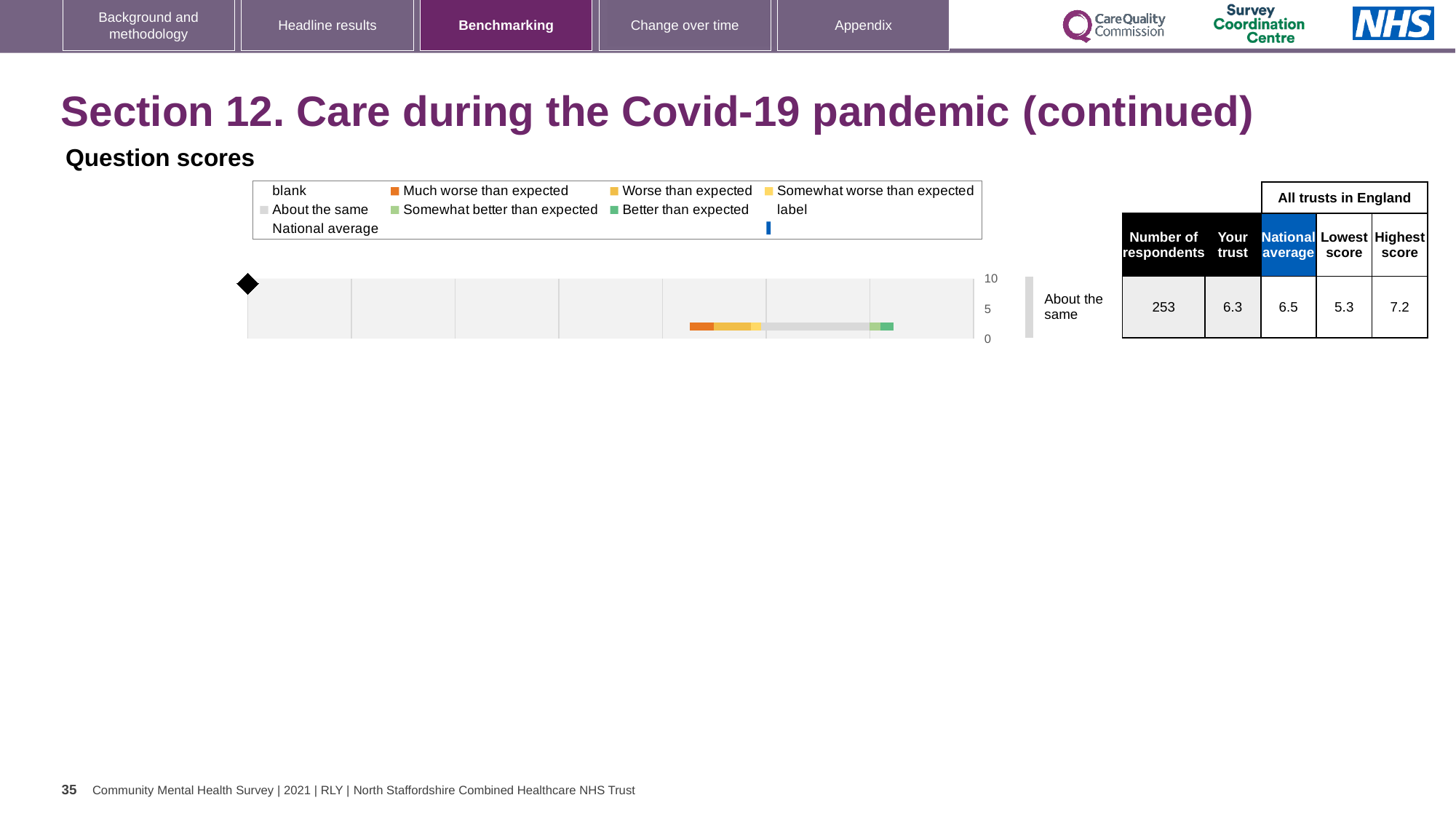
Which is larger, the 'Your trust' score or the national average score? National average Is the 'Your trust' score greater or less than 5? greater What is the 'Your trust' score shown for the question on this slide? 6.3 What is the maximum value shown on the chart's score axis? 10 What is the national average score shown for the question on this slide? 6.5 What is the difference between the highest score and the lowest score shown on this slide? 1.9 What is the lowest score among all trusts in England shown on this slide? 5.3 What is the highest score among all trusts in England shown on this slide? 7.2 How many respondents are shown for the question on this slide? 253 What kind of chart is shown under 'Question scores'? bar chart What benchmark category label is shown next to the chart row? About the same How many question rows are plotted in the chart on this slide? 1